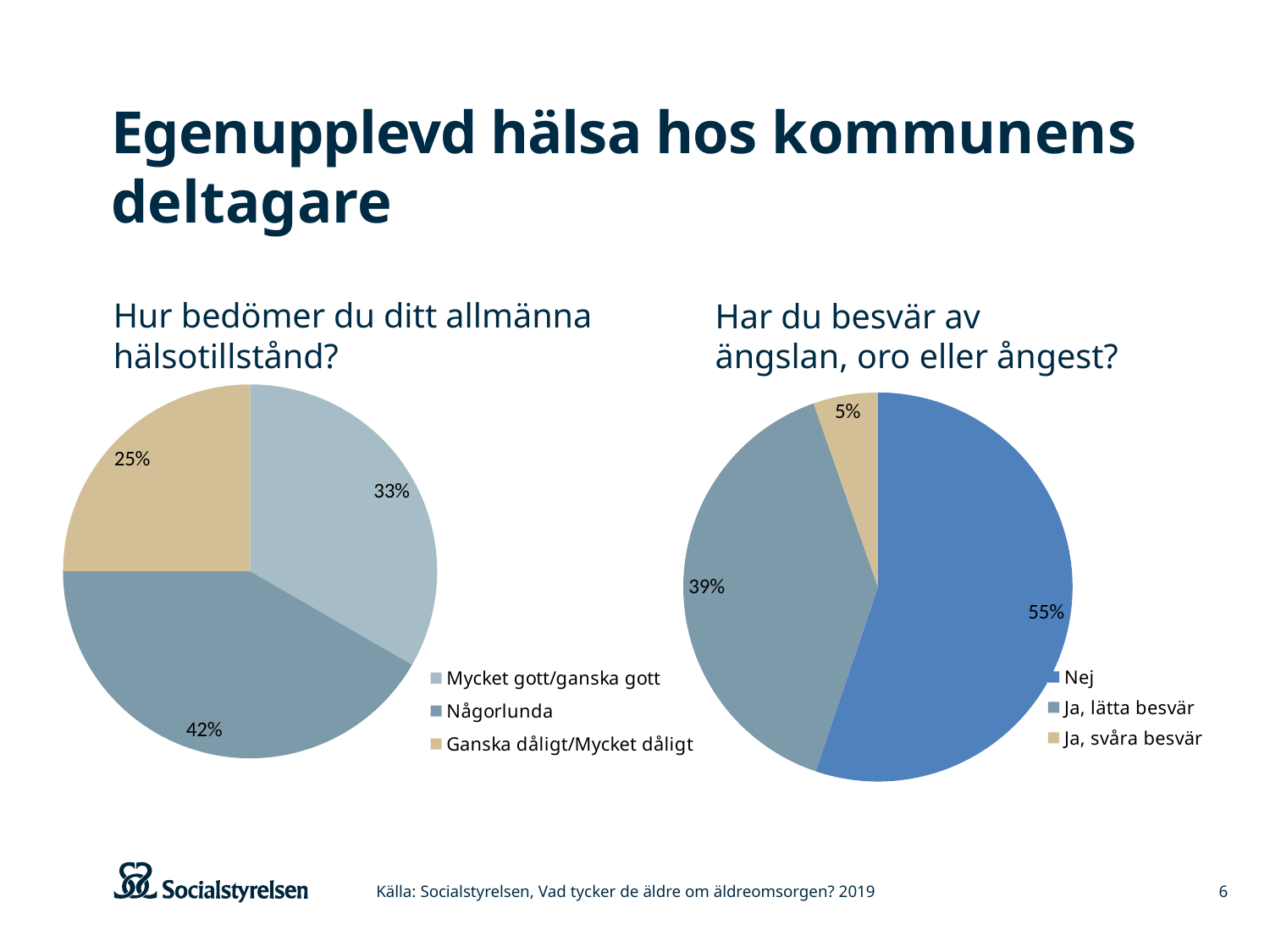
In the left pie chart ("Hur bedömer du ditt allmänna hälsotillstånd?"), what share is labelled for Mycket gott/ganska gott? 33% In the right pie chart ("Har du besvär av ängslan, oro eller ångest?"), what share is labelled for Ja, svåra besvär? 5% What kind of chart is used for "Hur bedömer du ditt allmänna hälsotillstånd?" on the left? Pie chart In the left pie chart ("Hur bedömer du ditt allmänna hälsotillstånd?"), how many percentage points larger is Någorlunda than Mycket gott/ganska gott? 9 percentage points In the left pie chart ("Hur bedömer du ditt allmänna hälsotillstånd?"), what share is labelled for Någorlunda? 42% In the right pie chart ("Har du besvär av ängslan, oro eller ångest?"), how many categories does the legend list? 3 In the left pie chart ("Hur bedömer du ditt allmänna hälsotillstånd?"), which category has the smallest slice? Ganska dåligt/Mycket dåligt In the right pie chart ("Har du besvär av ängslan, oro eller ångest?"), what share is labelled for Nej? 55% In the right pie chart ("Har du besvär av ängslan, oro eller ångest?"), what share is labelled for Ja, lätta besvär? 39% In the left pie chart ("Hur bedömer du ditt allmänna hälsotillstånd?"), which category has the largest slice? Någorlunda In the left pie chart ("Hur bedömer du ditt allmänna hälsotillstånd?"), what share is labelled for Ganska dåligt/Mycket dåligt? 25% In the right pie chart ("Har du besvär av ängslan, oro eller ångest?"), which category has the smallest slice? Ja, svåra besvär